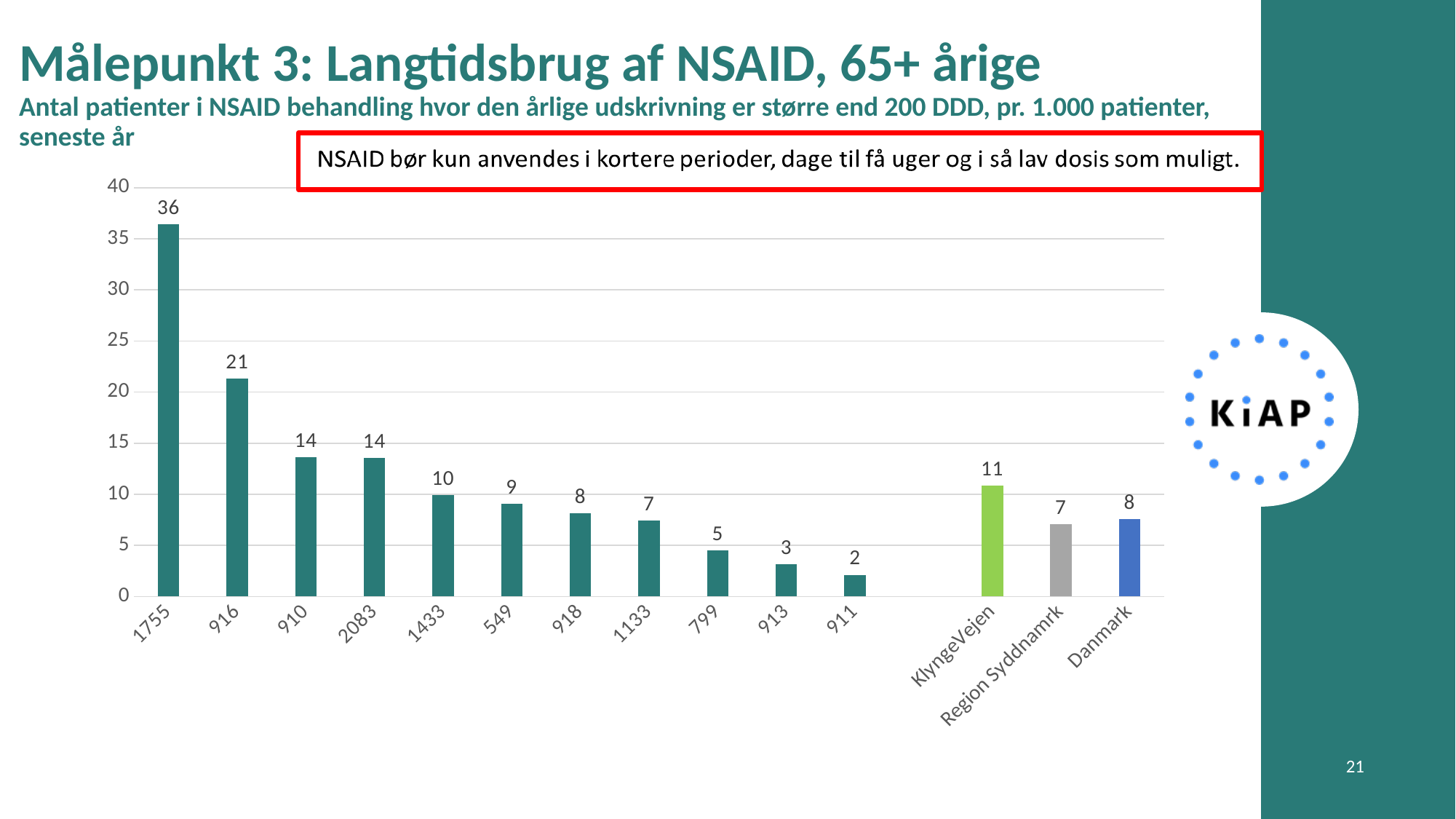
Which category has the highest value? 1755 How many bars are shown in the chart? 14 What is the value for KlyngeVejen? 11 What is the difference between the values for 1755 and 916? 15 What is the value for category 1755? 36 Which is larger, the value for 1433 or the value for 549? 1433 What is the value for Danmark? 8 What is the difference between the values for KlyngeVejen and Danmark? 3 What kind of chart is shown on the slide? Bar chart What colour is the bar for KlyngeVejen? Green Which category has the lowest value? 911 What is the value for Region Syddnamrk? 7